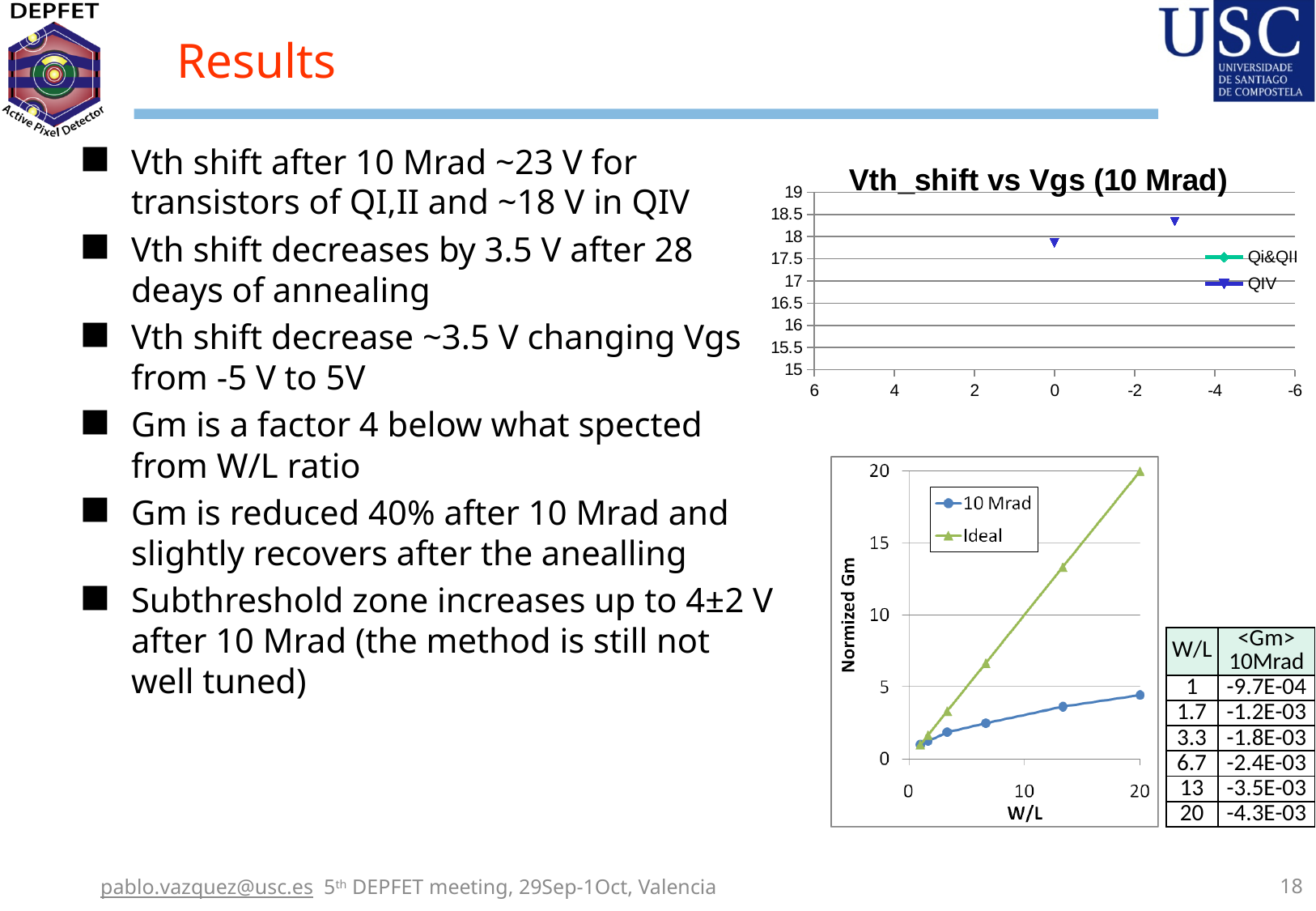
How many series does the legend of the 'Vth_shift vs Vgs (10 Mrad)' chart list? 2 In the Normized Gm vs W/L chart, is the 10 Mrad value at W/L = 20 greater or less than 5? less How many series does the legend of the Normized Gm vs W/L chart list? 2 In the Normized Gm vs W/L chart, does the Ideal series rise or fall as W/L increases? rise How many data points does the Ideal series have in the Normized Gm vs W/L chart? 6 In the 'Vth_shift vs Vgs (10 Mrad)' chart, is the QIV value at Vgs = 0 greater or less than 17.5? greater What are the legend entries of the 'Vth_shift vs Vgs (10 Mrad)' chart? Qi&QII and QIV What kind of chart is the 'Vth_shift vs Vgs (10 Mrad)' chart? scatter chart What kind of chart is the bottom-right chart of Normized Gm versus W/L? line chart In the Normized Gm vs W/L chart, which series is higher at W/L = 20: 10 Mrad or Ideal? Ideal